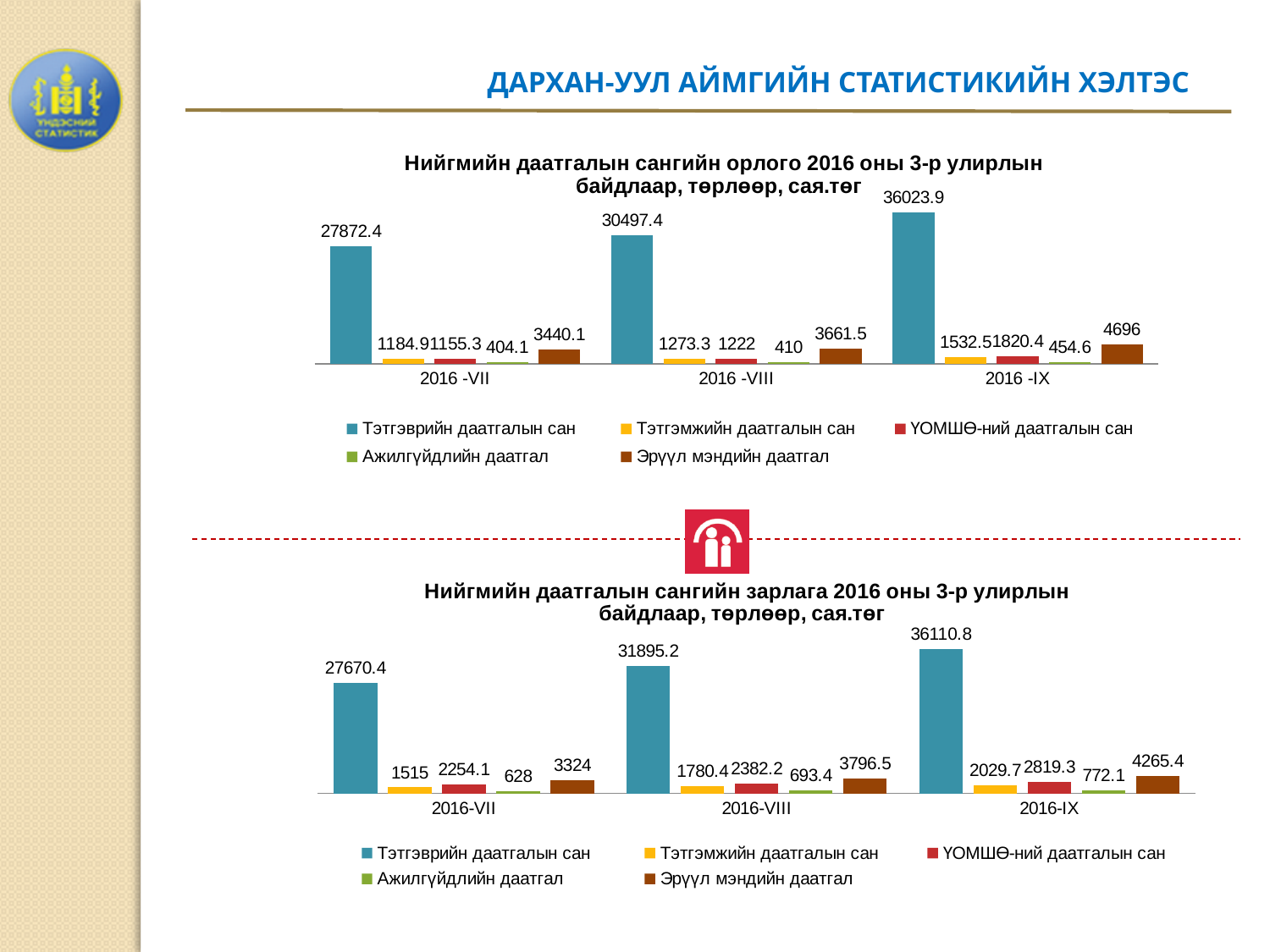
In the top chart (Нийгмийн даатгалын сангийн орлого), what is the difference between the Тэтгэврийн даатгалын сан values for 2016 -IX and 2016 -VII? 8151.5 In the top chart (Нийгмийн даатгалын сангийн орлого), what is the value of Тэтгэврийн даатгалын сан for 2016 -IX? 36023.9 In the bottom chart (Нийгмийн даатгалын сангийн зарлага), which is larger for 2016-VII: Тэтгэмжийн даатгалын сан or ҮОМШӨ-ний даатгалын сан? ҮОМШӨ-ний даатгалын сан In the top chart (Нийгмийн даатгалын сангийн орлого), how many series does the legend list? 5 In the bottom chart (Нийгмийн даатгалын сангийн зарлага), does the value of Тэтгэврийн даатгалын сан rise or fall from 2016-VII to 2016-IX? rise In the bottom chart (Нийгмийн даатгалын сангийн зарлага), which month has the lowest value for Ажилгүйдлийн даатгал? 2016-VII In the bottom chart (Нийгмийн даатгалын сангийн зарлага), what is the value of ҮОМШӨ-ний даатгалын сан for 2016-IX? 2819.3 In the bottom chart (Нийгмийн даатгалын сангийн зарлага), what is the value of Тэтгэврийн даатгалын сан for 2016-VIII? 31895.2 In the top chart (Нийгмийн даатгалын сангийн орлого), what is the value of Эрүүл мэндийн даатгал for 2016 -VII? 3440.1 In the top chart (Нийгмийн даатгалын сангийн орлого), what is the value of Ажилгүйдлийн даатгал for 2016 -VIII? 410 In the top chart (Нийгмийн даатгалын сангийн орлого), which month has the highest value for Тэтгэврийн даатгалын сан? 2016 -IX What type of chart is the bottom chart (Нийгмийн даатгалын сангийн зарлага)? bar chart